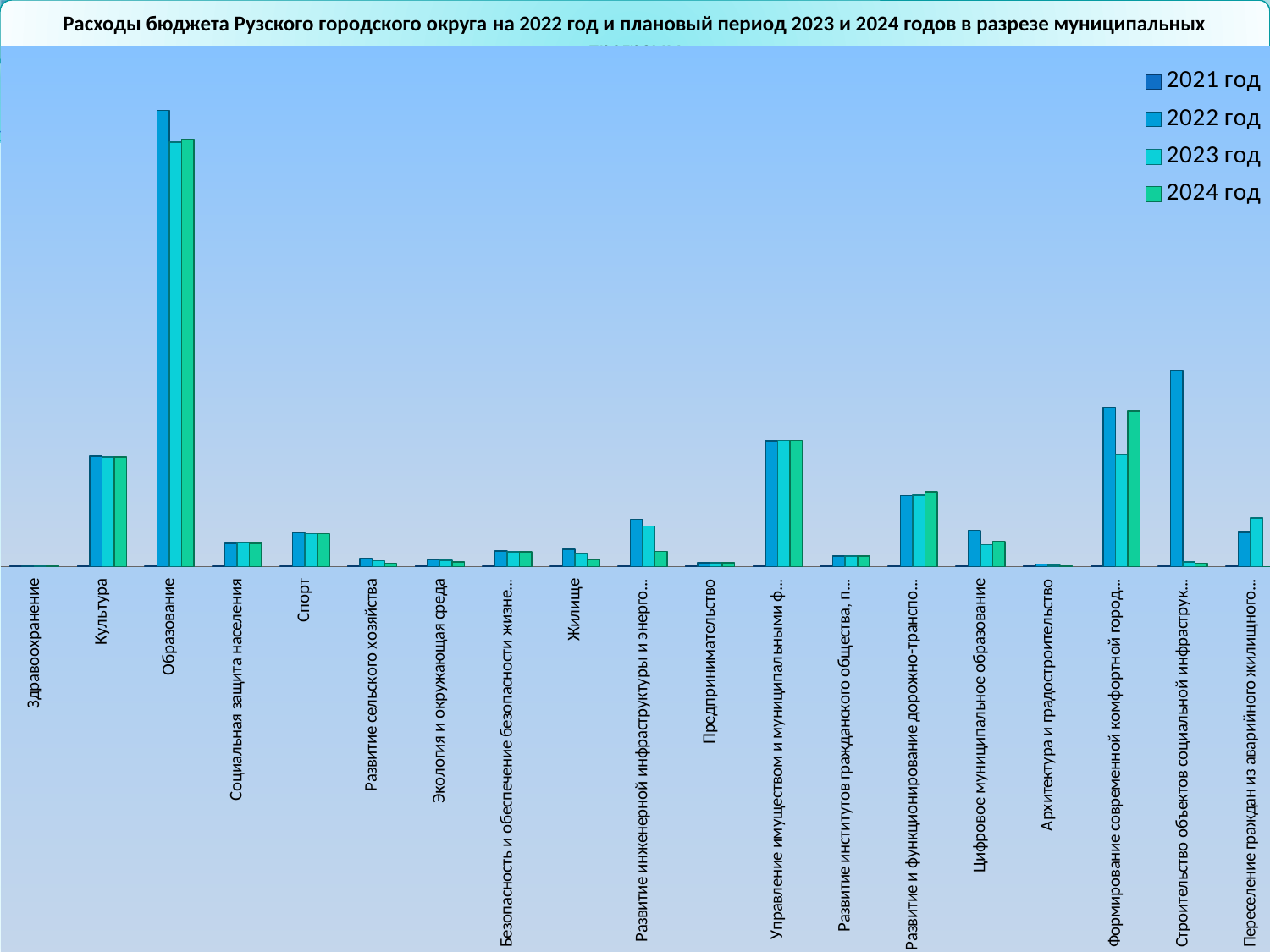
What kind of chart is shown on the slide? Bar chart Which category has the highest value for 2022 год? Образование For Строительство объектов социальной инфраструк..., do the values rise or fall from 2022 год to 2024 год? Fall For Строительство объектов социальной инфраструк..., which is larger: the value for 2022 год or for 2024 год? 2022 год Which year does the legend list first? 2021 год Which category has the highest value for 2024 год? Образование How many series does the legend list? 4 For Образование, which is larger: the value for 2022 год or for 2023 год? 2022 год For Формирование современной комфортной город..., which is larger: the value for 2022 год or for 2023 год? 2022 год How many categories are shown along the x axis? 19 Which category has the second highest value for 2022 год? Строительство объектов социальной инфраструк...